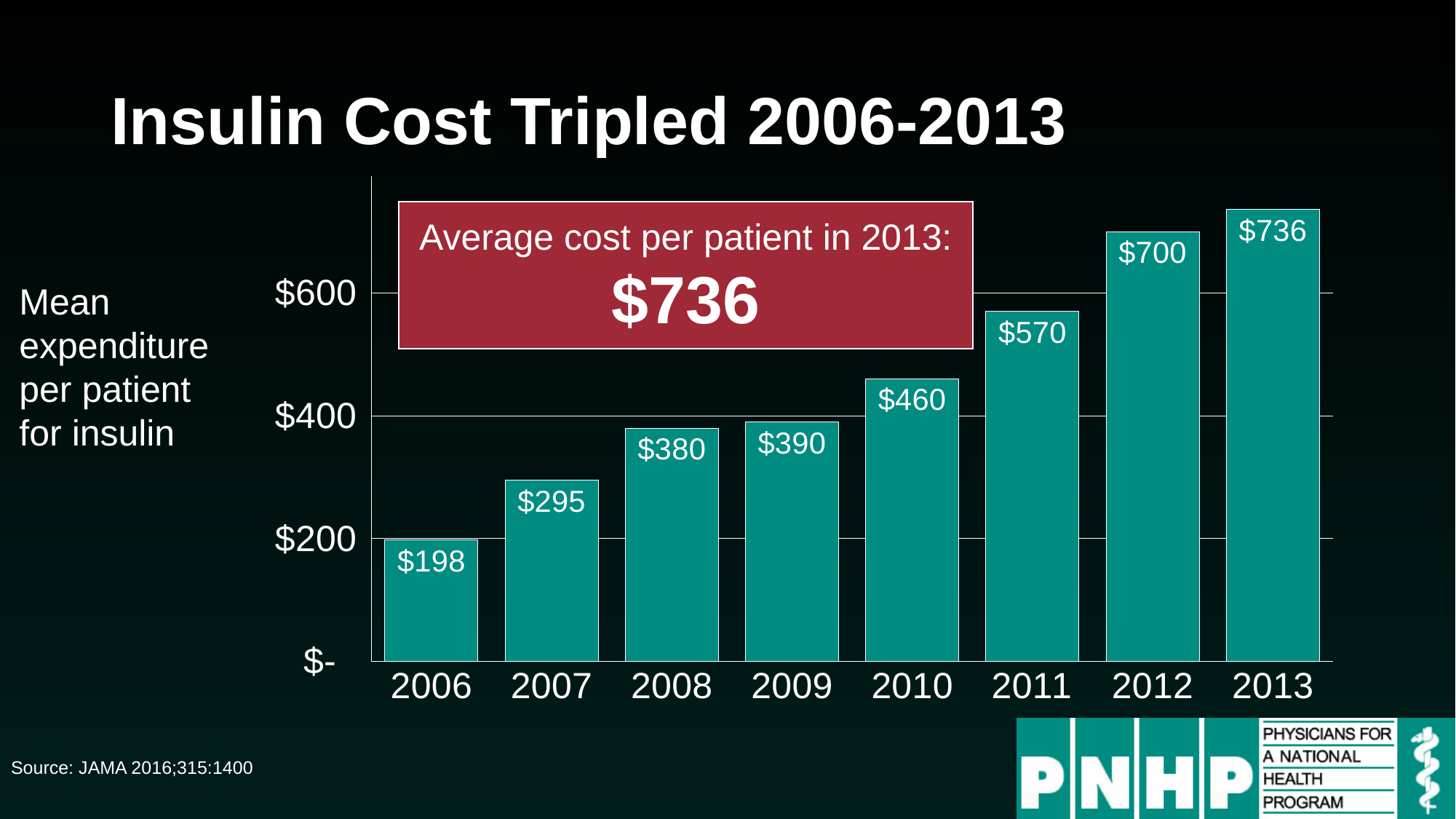
Which year had a higher mean expenditure per patient for insulin, 2008 or 2011? 2011 Which year has the lowest mean expenditure per patient for insulin? 2006 Is the value for 2009 greater or less than $400? less What was the mean expenditure per patient for insulin in 2006? $198 Which year has the highest mean expenditure per patient for insulin? 2013 What kind of chart is shown on the slide? Bar chart How many years are shown on the x axis of the chart? 8 What is the difference between the mean expenditure per patient in 2013 and in 2006? $538 What is the difference between the mean expenditure per patient in 2011 and in 2010? $110 Do the values rise or fall from 2006 to 2013? Rise What was the mean expenditure per patient for insulin in 2010? $460 What was the mean expenditure per patient for insulin in 2012? $700